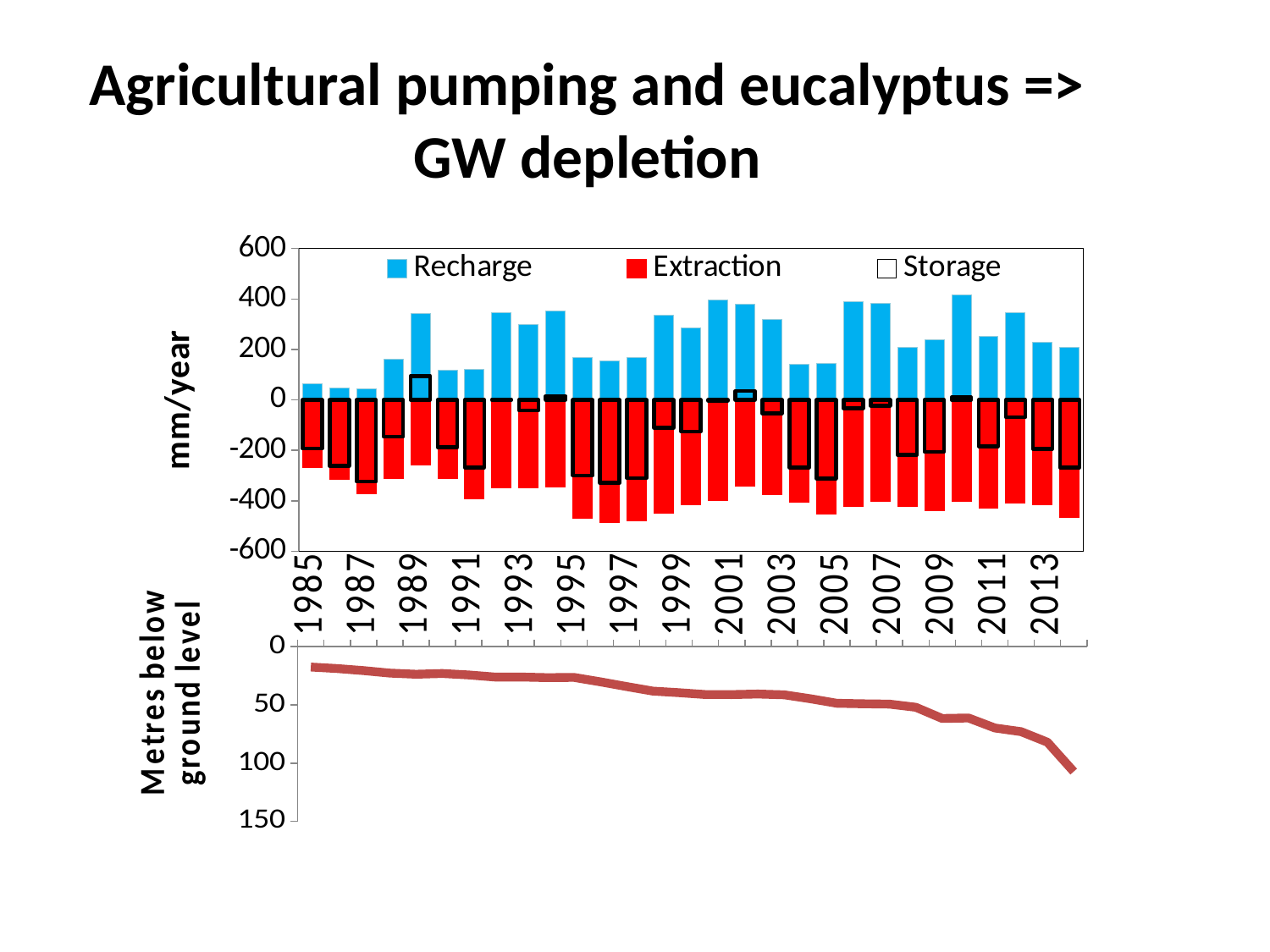
In the top chart, how many years are plotted along the x axis? 29 What kind of chart is the top chart? bar chart In the top chart, is the Extraction value for 1996 greater or less than -400? less In the top chart, how many series does the legend list? 3 What is the y-axis label of the top chart? mm/year In the top chart, is the Recharge value for 1985 greater or less than 200? less In the bottom chart, does the depth in metres below ground level increase or decrease from 1985 to 2014? increase In the top chart, what are the three series named in the legend? Recharge, Extraction, Storage What kind of chart is the bottom chart? line chart In the top chart, is the Recharge value for 2001 greater or less than 200? greater